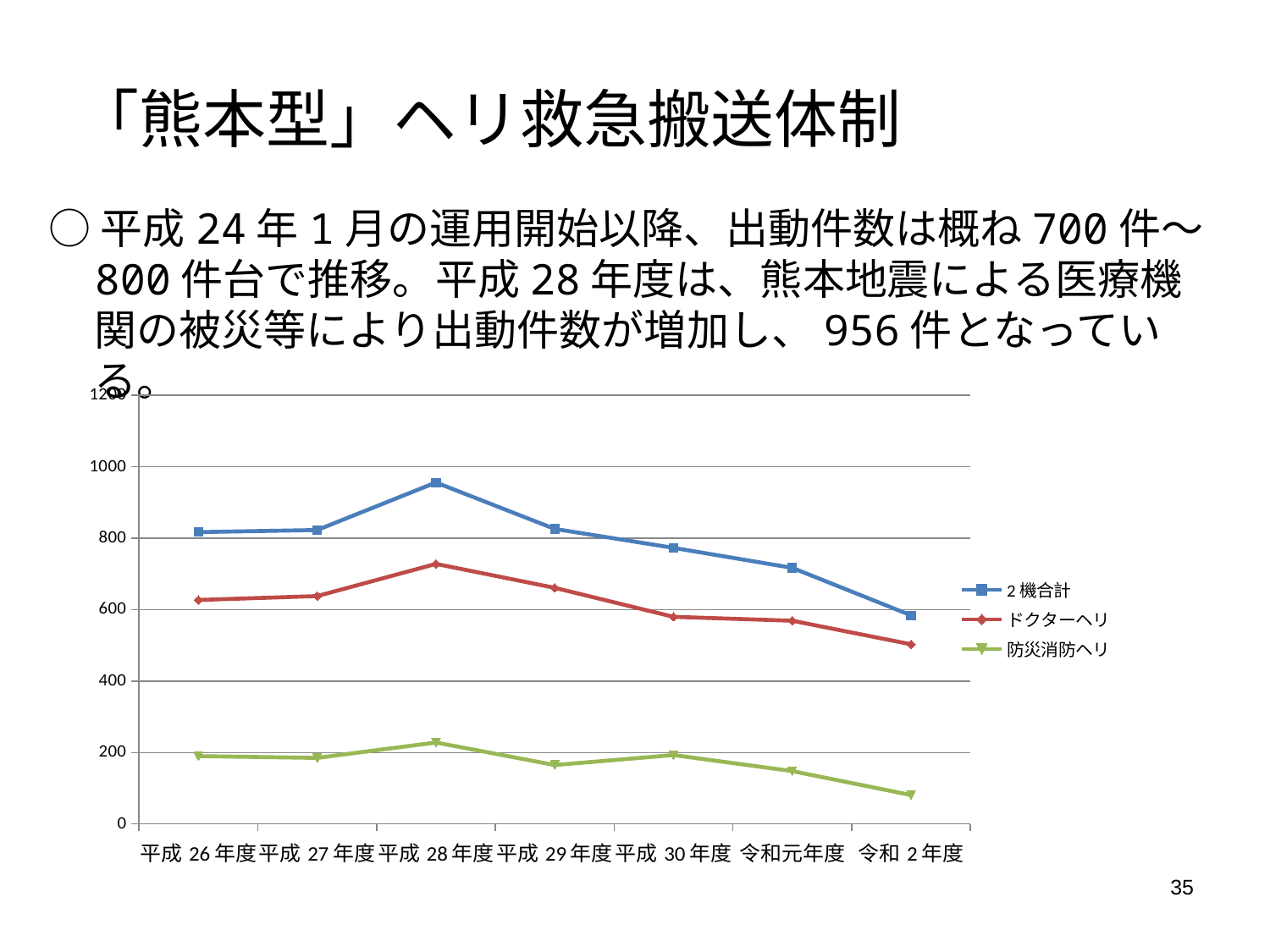
Is the value for 防災消防ヘリ in 令和2年度 greater or less than 200? less In which fiscal year is the 防災消防ヘリ series at its lowest? 令和2年度 Is the value for 2機合計 in 令和2年度 greater or less than 600? less From 平成28年度 to 令和2年度, does the 2機合計 series rise or fall? fall What kind of chart is shown on the slide? line chart In which fiscal year does the 2機合計 series reach its lowest value? 令和2年度 How many series does the chart legend list? 3 Which series has the larger value in 平成26年度, ドクターヘリ or 防災消防ヘリ? ドクターヘリ Is the value for ドクターヘリ in 平成28年度 greater or less than 600? greater How many fiscal years are plotted along the x axis of the chart? 7 In which fiscal year does the 2機合計 series reach its highest value? 平成28年度